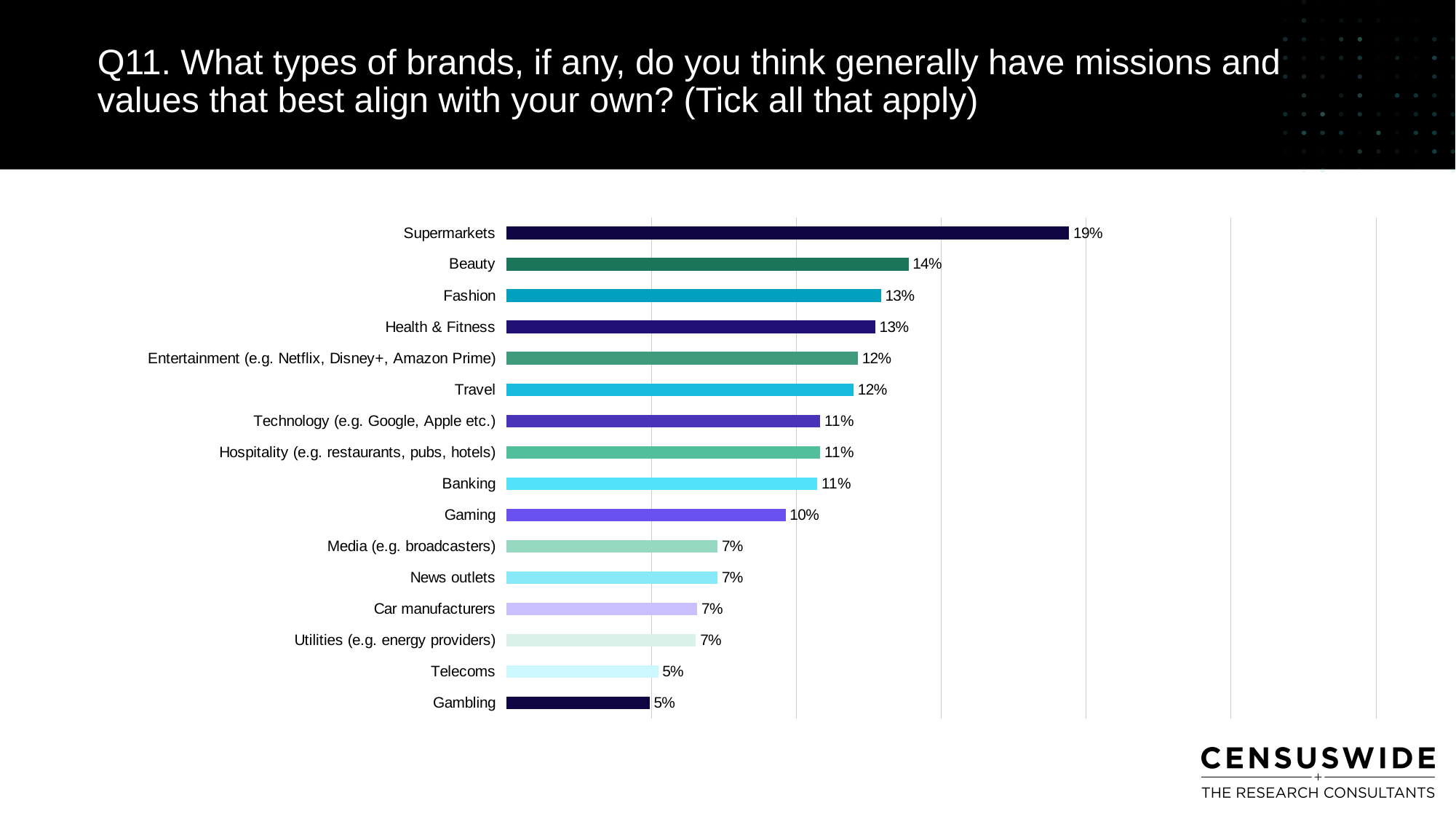
Which has a larger value, Beauty or Gaming? Beauty Which brand type has the highest percentage? Supermarkets What type of chart is shown on the slide? Bar chart What is the difference between the values for Supermarkets and Beauty? 5% Which has a larger value, Travel or Media (e.g. broadcasters)? Travel What is the value for Telecoms? 5% What percentage is shown for Gaming? 10% What is the value for Technology (e.g. Google, Apple etc.)? 11% What is the difference between the values for Fashion and Gambling? 8% What percentage of respondents selected Supermarkets? 19% What is the value shown for Beauty? 14% How many brand types are shown in the chart? 16